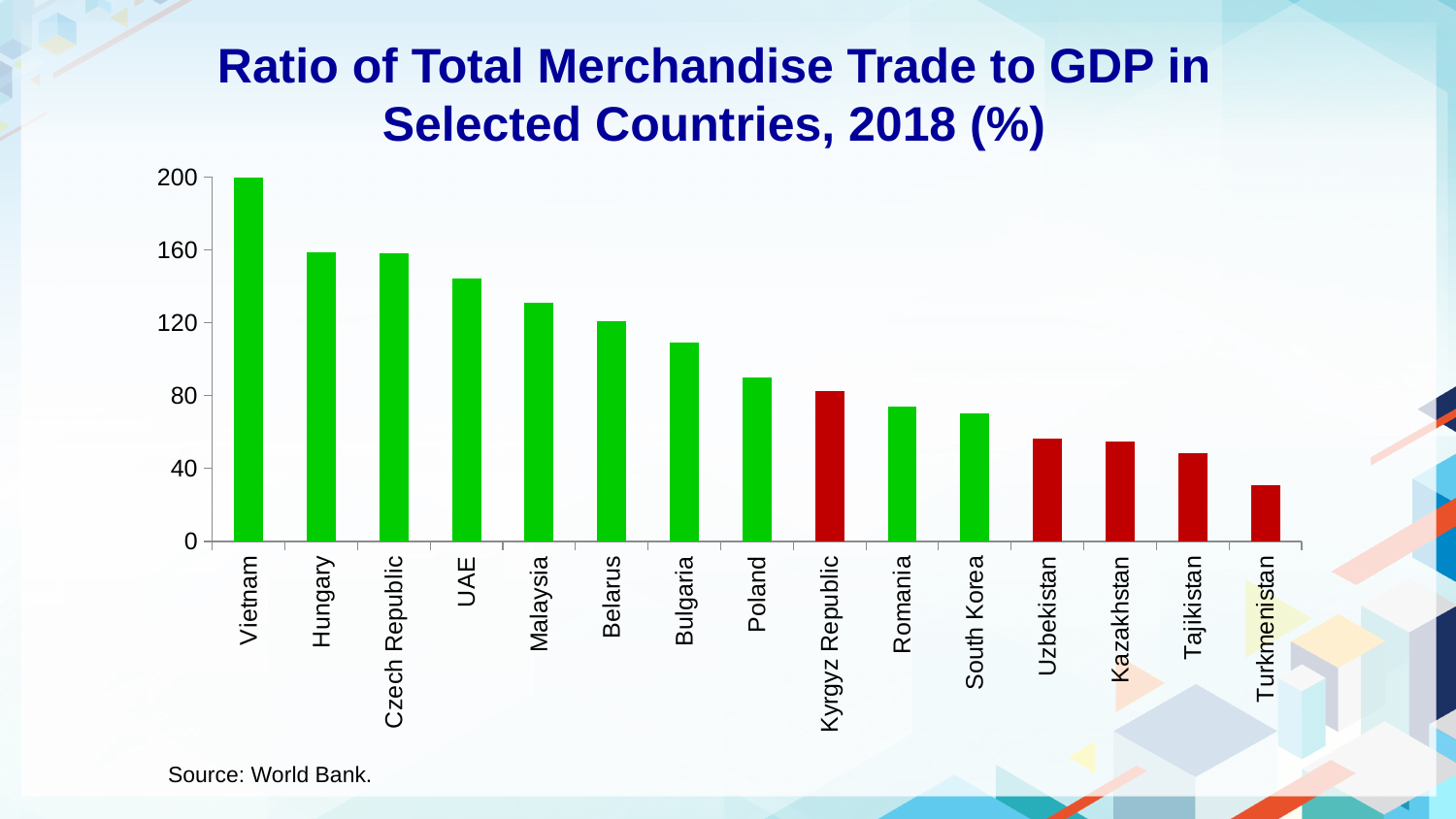
What is the source cited for the chart? World Bank Which country has the highest ratio of total merchandise trade to GDP? Vietnam Is the value for Bulgaria greater or less than 120? less Which country has the lowest ratio of total merchandise trade to GDP? Turkmenistan Is the value for Romania greater or less than 80? less Is the value for Poland greater or less than 80? greater What kind of chart is shown on the slide? bar chart Which has a larger value, UAE or Malaysia? UAE Do the values rise or fall from left to right along the x axis? fall How many countries are shown in the chart? 15